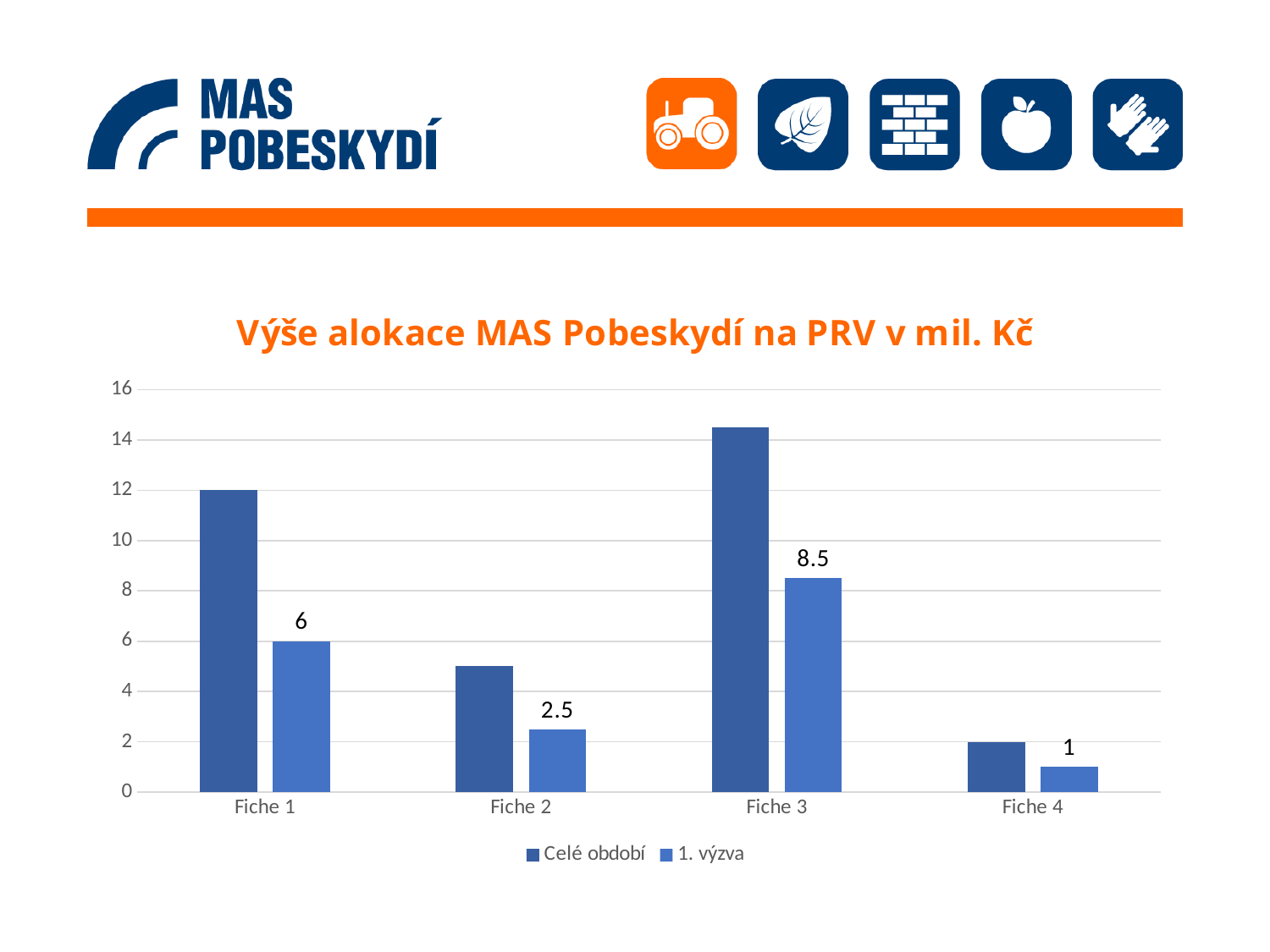
What is the value for Fiche 1 in the Celé období series? 12 Is the Celé období value for Fiche 3 greater or less than 14? greater Is the Celé období value for Fiche 2 greater or less than 6? less What is the value for Fiche 2 in the 1. výzva series? 2.5 What is the difference between the 1. výzva values for Fiche 1 and Fiche 4? 5 Which category has the highest value in the 1. výzva series? Fiche 3 What kind of chart is shown on the slide? bar chart Which category has the lowest value in the 1. výzva series? Fiche 4 How many categories are shown on the x axis? 4 What is the value for Fiche 3 in the 1. výzva series? 8.5 In the 1. výzva series, which is larger: Fiche 1 or Fiche 2? Fiche 1 How many series does the legend list? 2